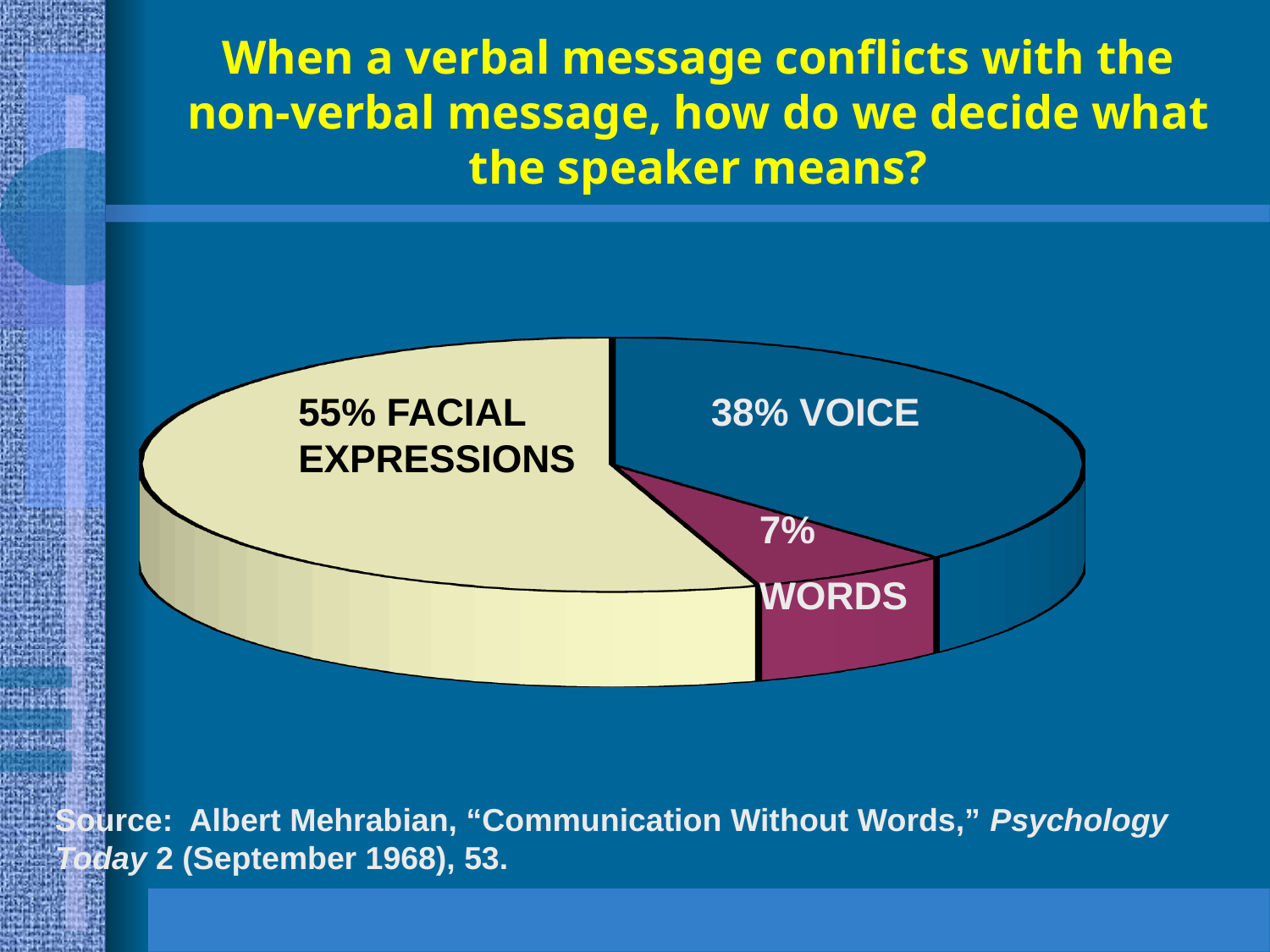
What colour is the WORDS slice of the pie? purple Which slice of the pie is the largest? FACIAL EXPRESSIONS What share of the pie is labelled FACIAL EXPRESSIONS? 55% Who is cited as the source of the data in the pie chart? Albert Mehrabian What is the difference in percentage points between the FACIAL EXPRESSIONS slice and the VOICE slice? 17 What kind of chart is shown on the slide? pie chart What share of the pie is labelled VOICE? 38% Which slice of the pie is the smallest? WORDS What share of the pie is labelled WORDS? 7% How many slices does the pie chart have? 3 Which is larger, the VOICE slice or the WORDS slice? VOICE What is the difference in percentage points between the VOICE slice and the WORDS slice? 31